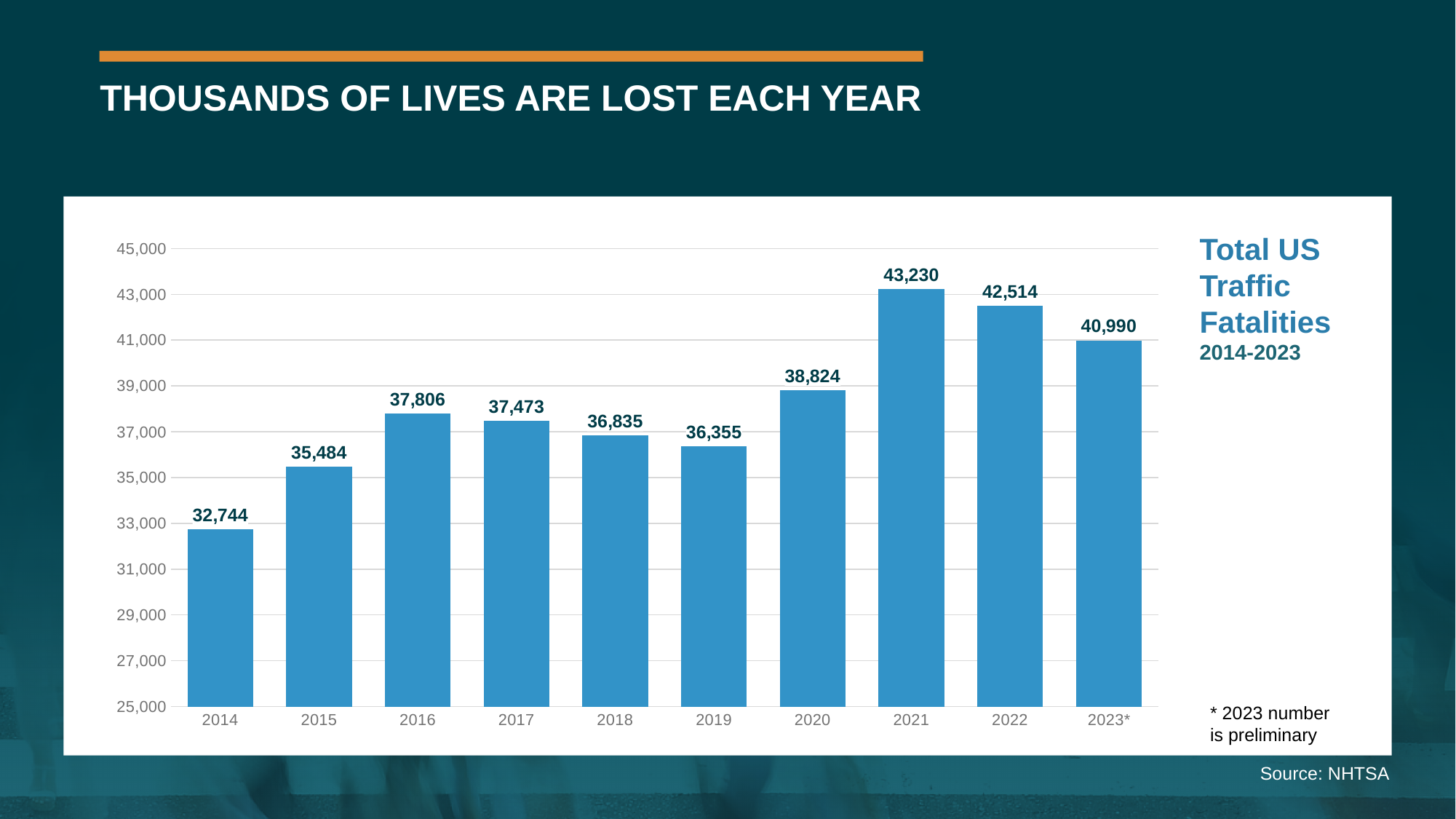
What is the value shown for 2023*? 40,990 Which year had the lowest number of traffic fatalities? 2014 What was the total number of US traffic fatalities in 2021? 43,230 Which year had the highest number of traffic fatalities? 2021 What was the total number of US traffic fatalities in 2014? 32,744 Which year had more traffic fatalities, 2016 or 2017? 2016 Is the value for 2020 greater or less than 39,000? less Did traffic fatalities rise or fall from 2019 to 2021? Rise What is the source cited for the chart data? NHTSA How many years are shown on the chart? 10 What kind of chart is shown on the slide? Bar chart What is the difference between the 2021 and 2022 fatality totals? 716